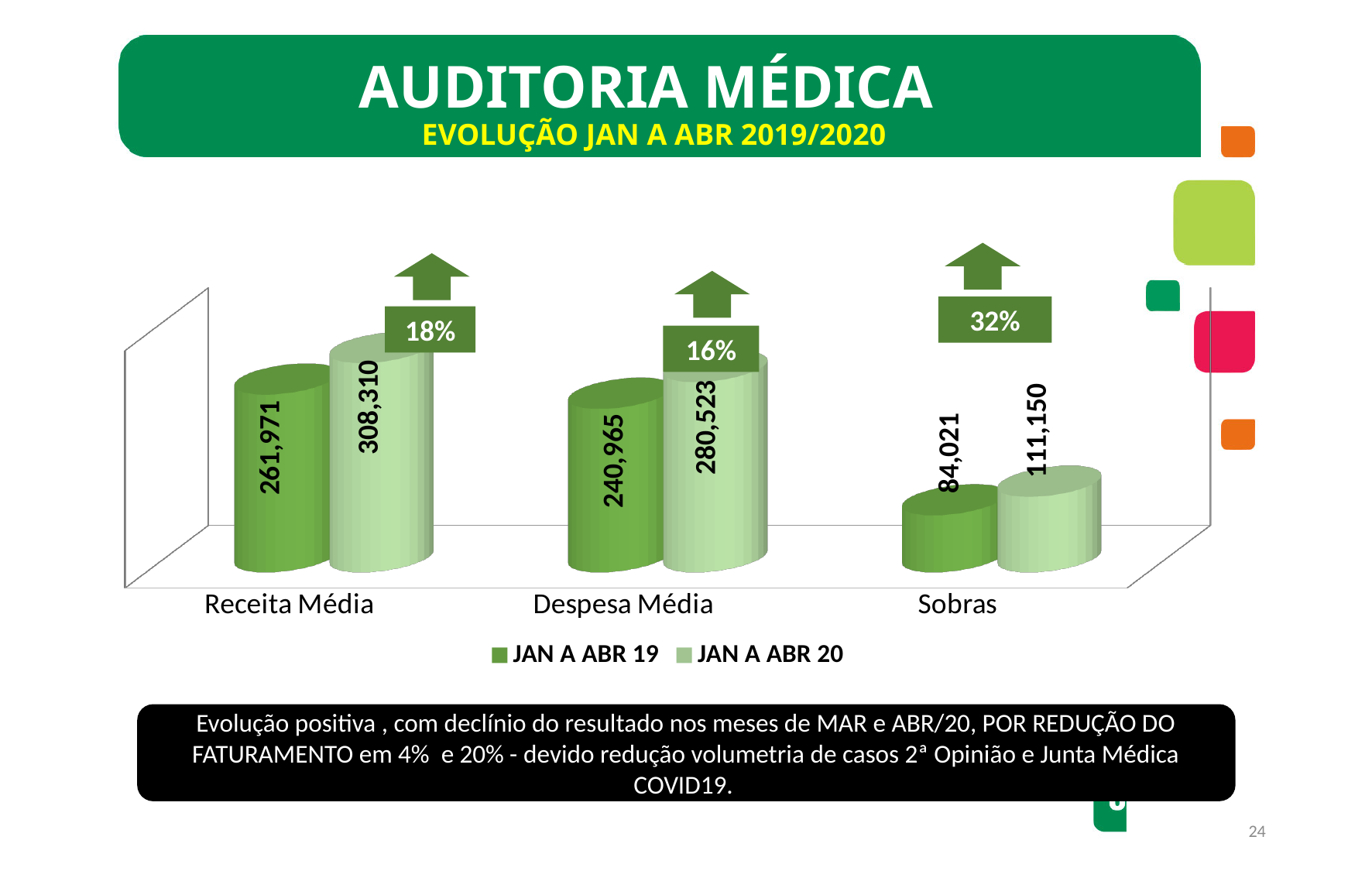
Which category has the highest value in the JAN A ABR 19 series? Receita Média What is the value for Sobras in the JAN A ABR 19 series? 84,021 Which is larger: Despesa Média for JAN A ABR 19 or Despesa Média for JAN A ABR 20? JAN A ABR 20 What is the value for Receita Média in the JAN A ABR 19 series? 261,971 What is the value for Despesa Média in the JAN A ABR 20 series? 280,523 Which category has the lowest value in the JAN A ABR 20 series? Sobras What is the difference between the JAN A ABR 20 and JAN A ABR 19 values for Sobras? 27,129 What percentage increase is labelled above the Sobras bars? 32% What is the value for Receita Média in the JAN A ABR 20 series? 308,310 What is the difference between the JAN A ABR 20 and JAN A ABR 19 values for Receita Média? 46,339 How many categories are shown on the x axis of the chart? 3 How many series does the legend list? 2